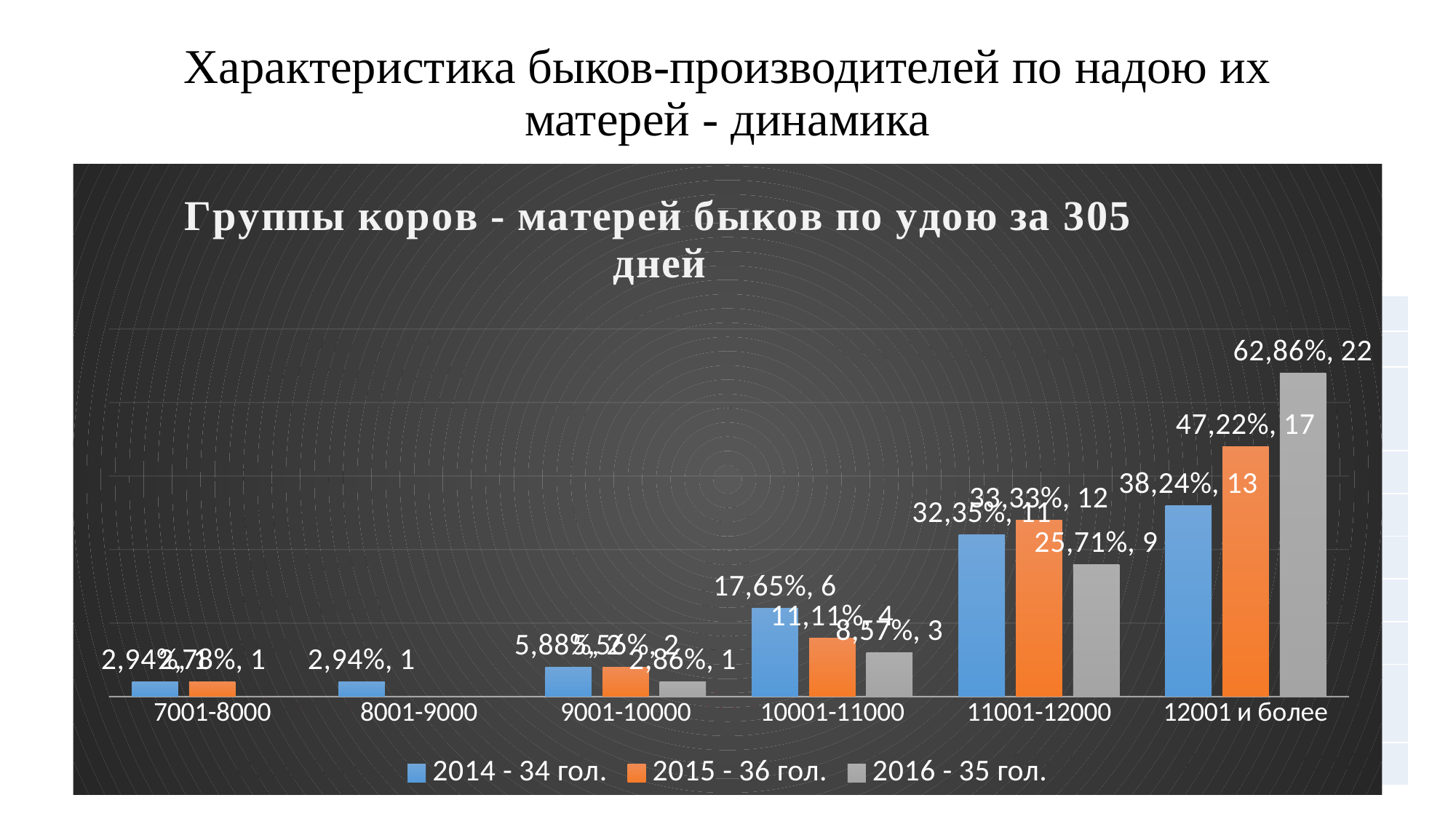
What is the data label for the 2016 - 35 гол. series in the 12001 и более category? 62,86%, 22 What kind of chart is shown on the slide? bar chart What is the data label for the 2016 - 35 гол. series in the 11001-12000 category? 25,71%, 9 Which series has the lowest value in the 10001-11000 category? 2016 - 35 гол. What is the difference in head count between the 2016 - 35 гол. and 2014 - 34 гол. series in the 12001 и более category? 9 How many series does the legend list? 3 What is the data label for the 2015 - 36 гол. series in the 12001 и более category? 47,22%, 17 Which category has the highest value for the 2016 - 35 гол. series? 12001 и более What is the data label for the 2014 - 34 гол. series in the 10001-11000 category? 17,65%, 6 How many categories are shown on the x axis? 6 What is the title of the chart? Группы коров - матерей быков по удою за 305 дней In the 11001-12000 category, which is larger: the 2014 - 34 гол. value or the 2016 - 35 гол. value? 2014 - 34 гол.